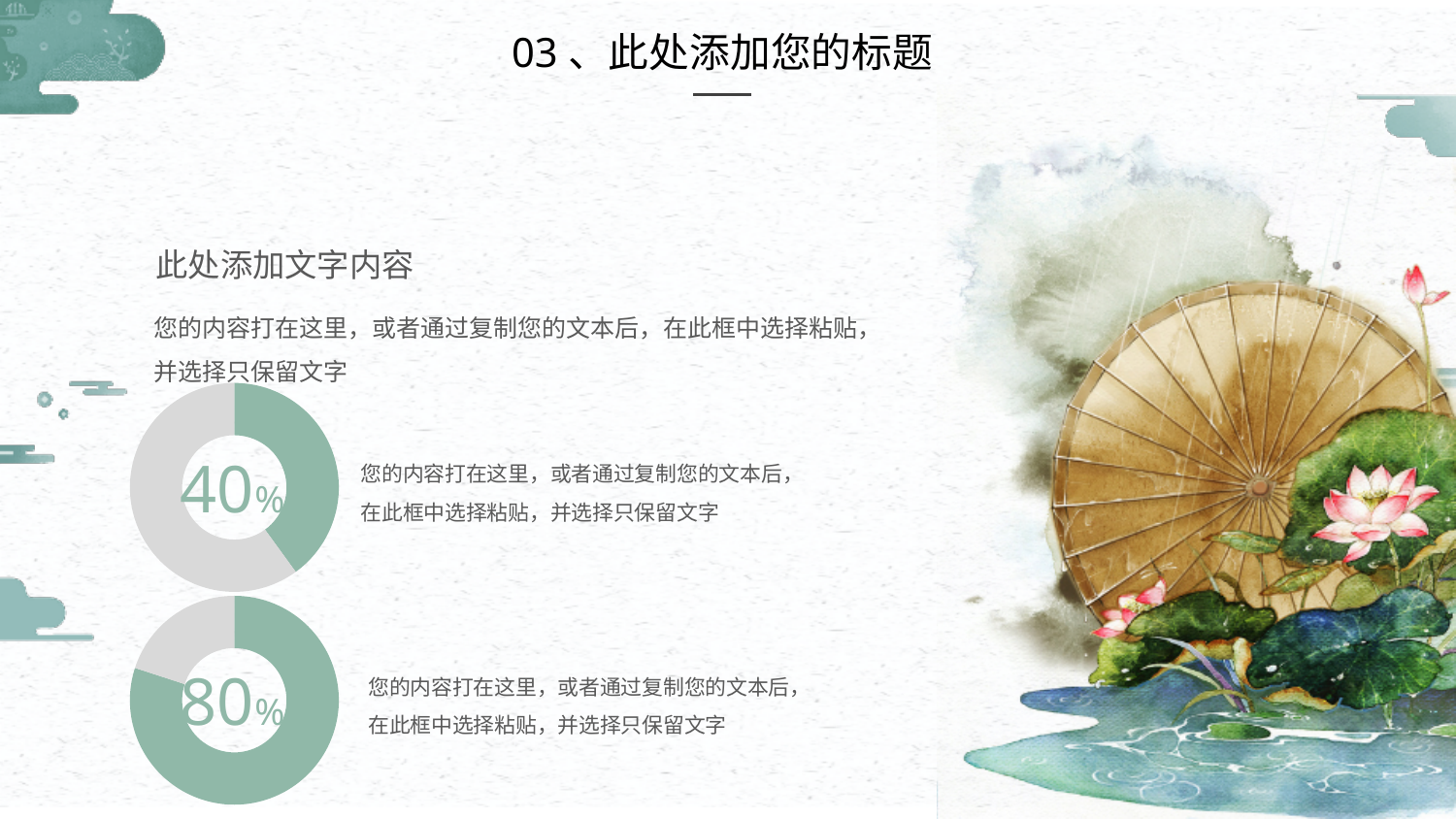
How many doughnut charts are on the slide? 2 What colour is the filled portion of the doughnut charts? green What kind of chart is the bottom chart on the left side of the slide? doughnut chart Which doughnut chart shows the larger percentage, the top one or the bottom one? the bottom one Is the value shown in the bottom doughnut chart greater or less than 50%? greater What kind of chart is the top chart on the left side of the slide? doughnut chart Which doughnut chart shows the smaller percentage, the top one or the bottom one? the top one What is the difference between the percentage in the bottom doughnut chart and the percentage in the top doughnut chart? 40% Is the value shown in the top doughnut chart greater or less than 50%? less What colour is the unfilled portion of the doughnut charts? grey What percentage is shown in the centre of the bottom doughnut chart? 80% What percentage is shown in the centre of the top doughnut chart? 40%